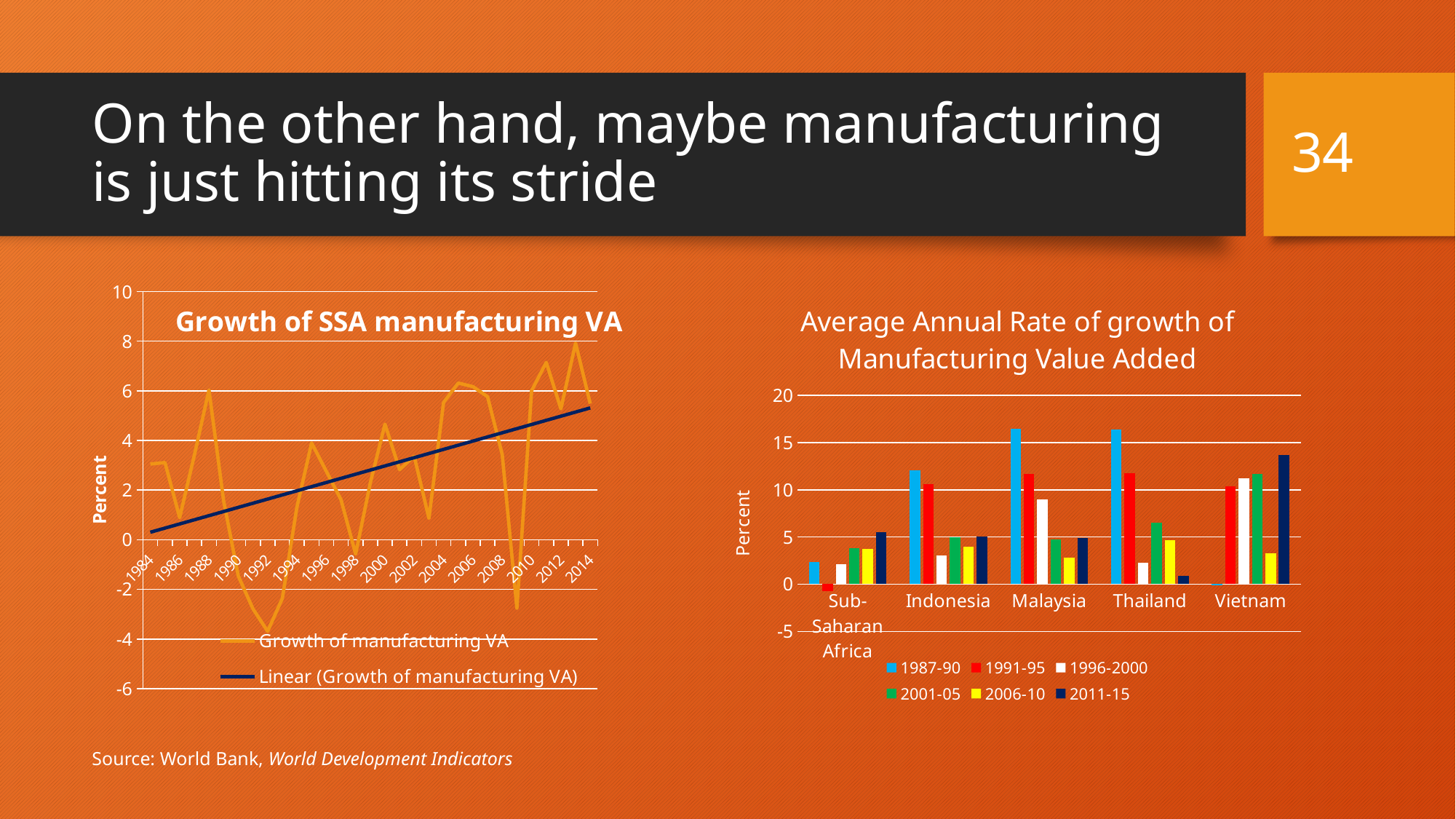
In the right chart 'Average Annual Rate of growth of Manufacturing Value Added', is the 2011-15 value for Thailand greater or less than 5? less In the left chart 'Growth of SSA manufacturing VA', does the linear trend line rise or fall from 1984 to 2014? rise In the left chart 'Growth of SSA manufacturing VA', is the growth value for 1992 greater or less than 0? less How many series does the legend of the right chart 'Average Annual Rate of growth of Manufacturing Value Added' list? 6 In the right chart 'Average Annual Rate of growth of Manufacturing Value Added', which is larger for 1987-90: Indonesia or Sub-Saharan Africa? Indonesia How many countries or regions are shown on the x axis of the right chart 'Average Annual Rate of growth of Manufacturing Value Added'? 5 What kind of chart is the left chart titled 'Growth of SSA manufacturing VA'? line chart In the left chart, what does the legend call the dark straight line? Linear (Growth of manufacturing VA) In the left chart 'Growth of SSA manufacturing VA', is the growth value for 2013 greater or less than 6? greater In the right chart 'Average Annual Rate of growth of Manufacturing Value Added', which period has the lowest value for Sub-Saharan Africa? 1991-95 What kind of chart is the right chart titled 'Average Annual Rate of growth of Manufacturing Value Added'? bar chart